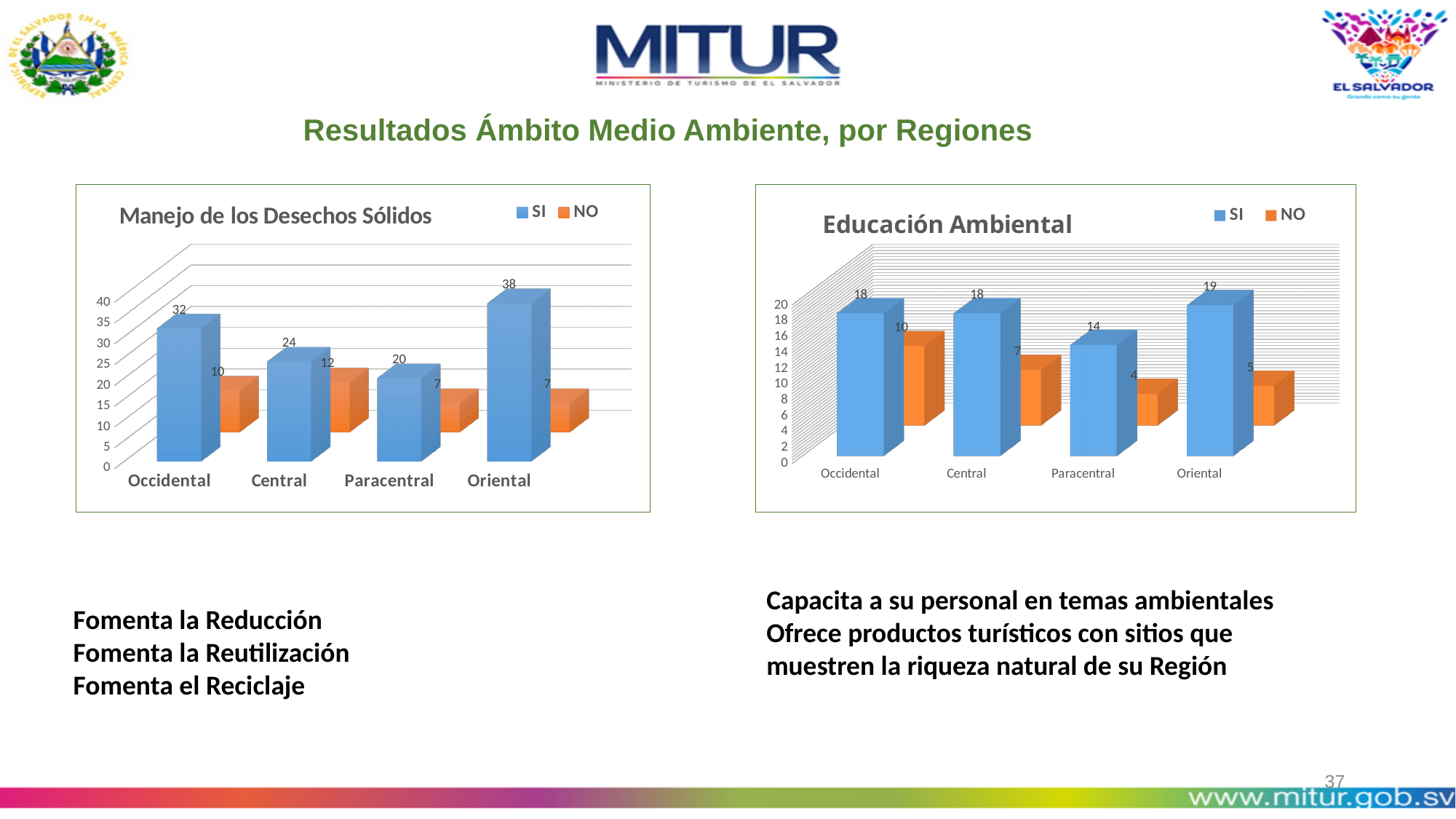
In the 'Educación Ambiental' chart, what is the SI value for Paracentral? 14 In the 'Manejo de los Desechos Sólidos' chart, which region has the lowest SI value? Paracentral In the 'Educación Ambiental' chart, which region has the lowest NO value? Paracentral In the 'Manejo de los Desechos Sólidos' chart, what is the NO value for Central? 12 In the 'Manejo de los Desechos Sólidos' chart, what is the difference between the SI and NO values for Occidental? 22 In the 'Educación Ambiental' chart, what is the NO value for Occidental? 10 In the 'Educación Ambiental' chart, is the NO value for Central larger or smaller than the NO value for Oriental? larger In the 'Manejo de los Desechos Sólidos' chart, how many series does the legend list? 2 In the 'Educación Ambiental' chart, how many regions are shown on the x axis? 4 In the 'Manejo de los Desechos Sólidos' chart, which region has the highest SI value? Oriental In the 'Manejo de los Desechos Sólidos' chart, what is the SI value for Oriental? 38 What type of chart is the 'Educación Ambiental' chart? Bar chart